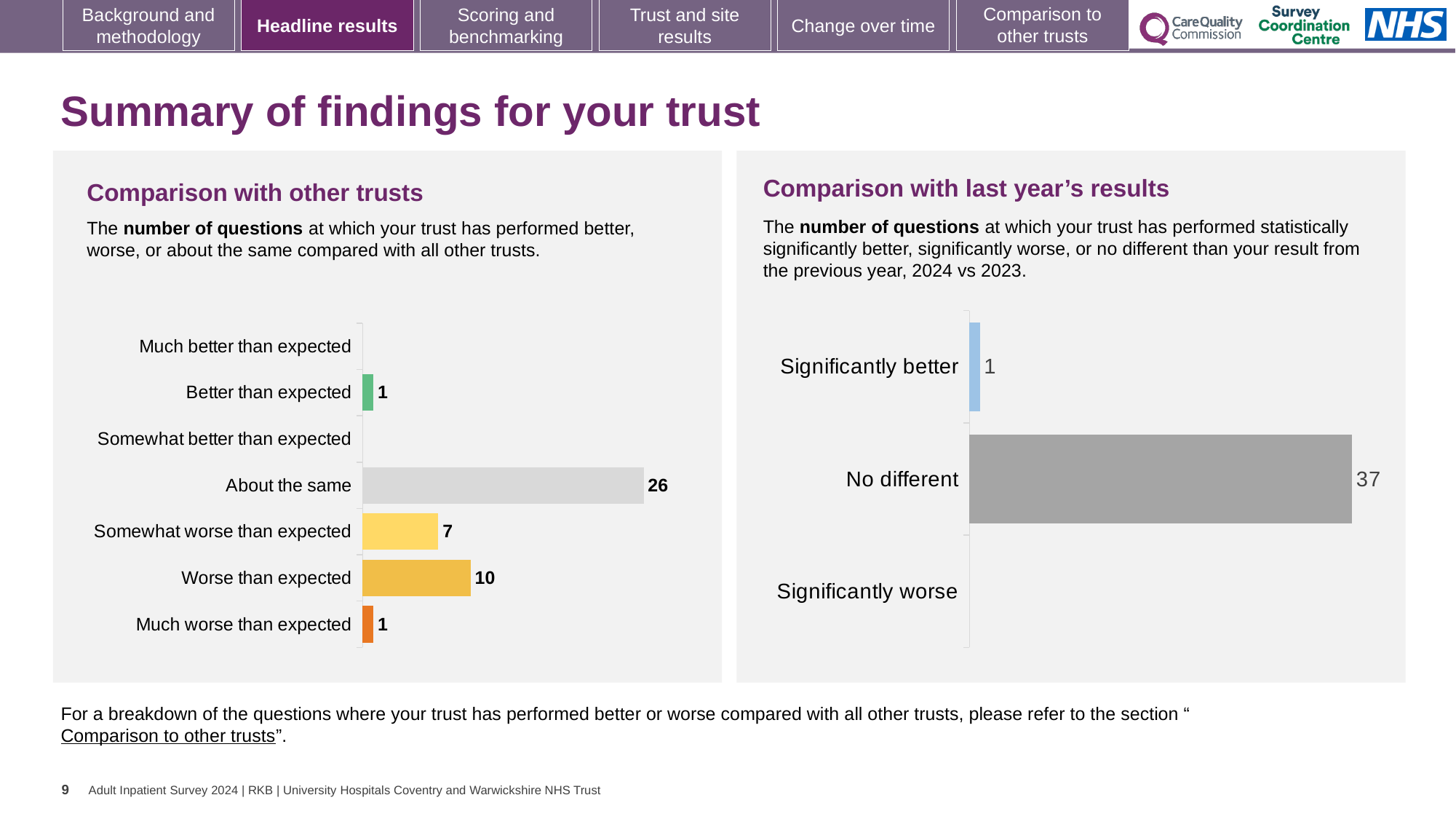
In the 'Comparison with other trusts' chart, what is the value for 'About the same'? 26 In the 'Comparison with last year's results' chart, what is the difference between 'No different' and 'Significantly better'? 36 In the 'Comparison with other trusts' chart, which is larger: 'Better than expected' or 'Worse than expected'? Worse than expected In the 'Comparison with other trusts' chart, what is the value for 'Worse than expected'? 10 How many categories are listed on the axis of the 'Comparison with other trusts' chart? 7 In the 'Comparison with other trusts' chart, what is the value for 'Somewhat worse than expected'? 7 What kind of chart is the 'Comparison with other trusts' chart? Bar chart In the 'Comparison with other trusts' chart, which category has the highest value? About the same In the 'Comparison with last year's results' chart, what is the value for 'No different'? 37 In the 'Comparison with last year's results' chart, what is the value for 'Significantly better'? 1 How many categories are listed on the axis of the 'Comparison with last year's results' chart? 3 In the 'Comparison with other trusts' chart, what is the difference between 'Worse than expected' and 'Somewhat worse than expected'? 3